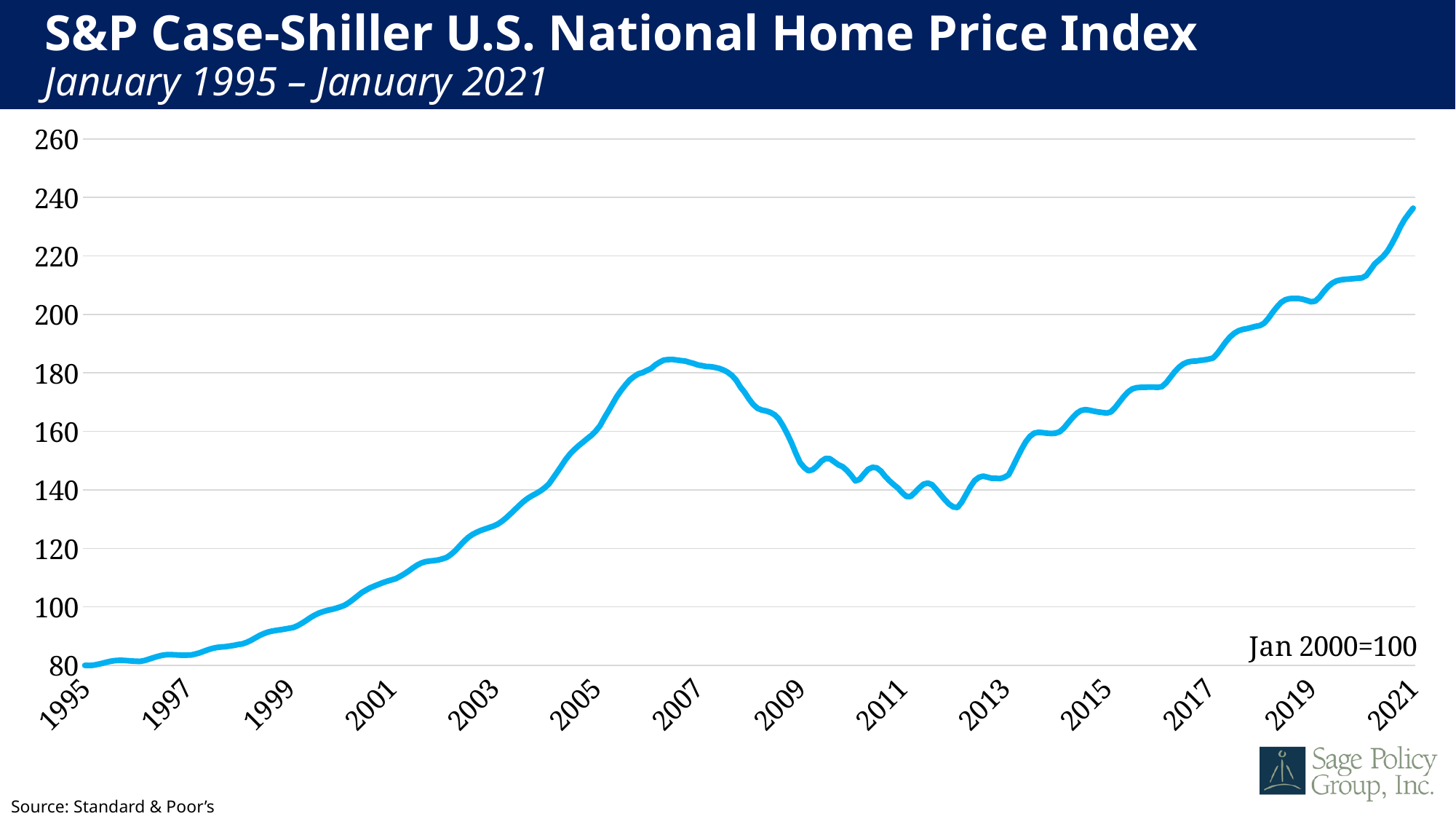
What is the source cited for the chart? Standard & Poor's Is the value for 1995 greater or less than 100? less What kind of chart is shown on the slide? line chart What is the title of the chart? S&P Case-Shiller U.S. National Home Price Index Is the value for 2017 greater or less than 160? greater Is the value for 2007 greater or less than 160? greater In which year shown on the x axis is the index at its lowest value? 1995 In which year shown on the x axis does the index reach its highest value? 2021 Does the index rise or fall between 2007 and 2012? fall